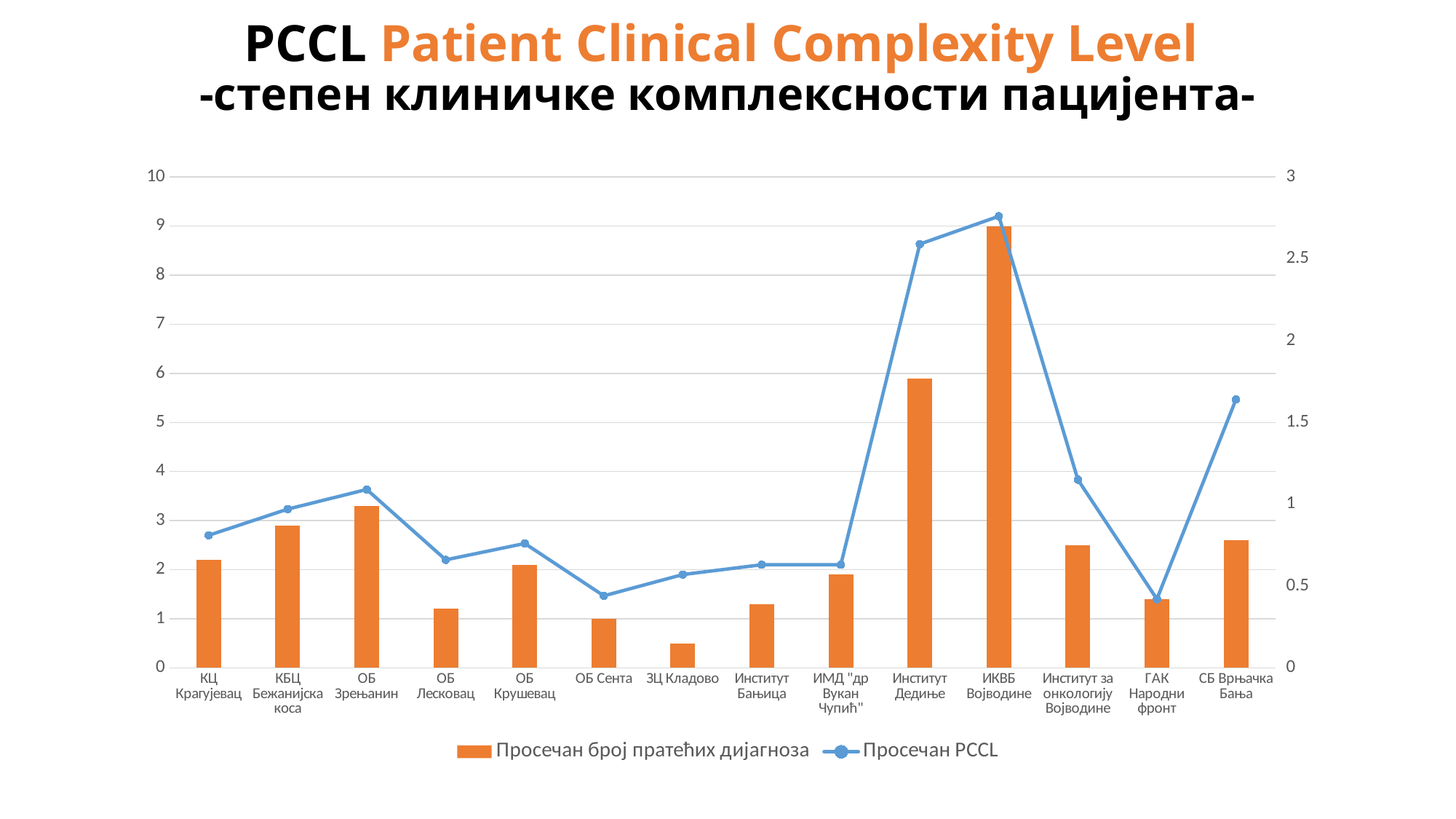
How many series does the legend list? 2 What colour are the bars for Просечан број пратећих дијагноза? Orange Which institution has the highest bar for Просечан број пратећих дијагноза? ИКВБ Војводине Which institution has the highest Просечан PCCL value on the line? ИКВБ Војводине Is the Просечан PCCL value for ОБ Лесковац greater or less than 1? less What is the Просечан број пратећих дијагноза value for ОБ Сента? 1 Which institution has the lowest bar for Просечан број пратећих дијагноза? ЗЦ Кладово Is the Просечан PCCL value for СБ Врњачка Бања greater or less than 1.5? greater Which has the larger Просечан број пратећих дијагноза bar: Институт Дедиње or Институт за онкологију Војводине? Институт Дедиње How many institutions (categories) are shown on the x axis? 14 Is the Просечан број пратећих дијагноза bar for ИКВБ Војводине greater or less than 8? greater What type of chart is shown on the slide? Combination bar and line chart